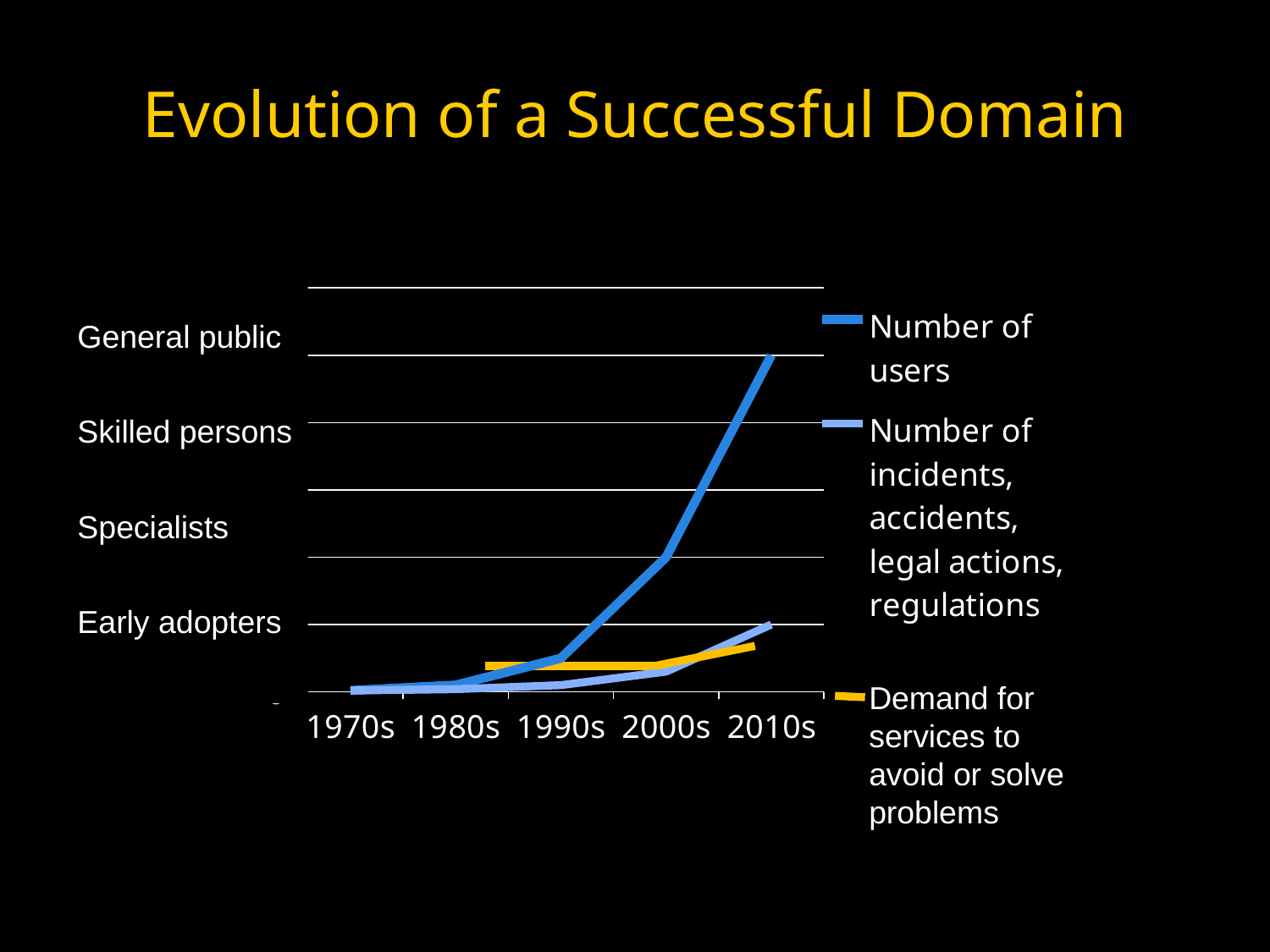
What is the topmost label on the y axis? General public In which decade does the Number of users line reach its highest point? 2010s In the 2010s, which is higher: Number of users or Number of incidents, accidents, legal actions, regulations? Number of users In which decade is the Number of users line at its lowest? 1970s Which series is drawn in yellow? Demand for services to avoid or solve problems What is the title of the chart on the slide? Evolution of a Successful Domain How many series does the legend list? 3 Does the Number of users line rise or fall from the 1970s to the 2010s? Rise Which series has the highest value in the 2010s? Number of users How many decades are shown along the x axis? 5 What kind of chart is shown on the slide? Line chart What is the first decade labelled on the x axis? 1970s